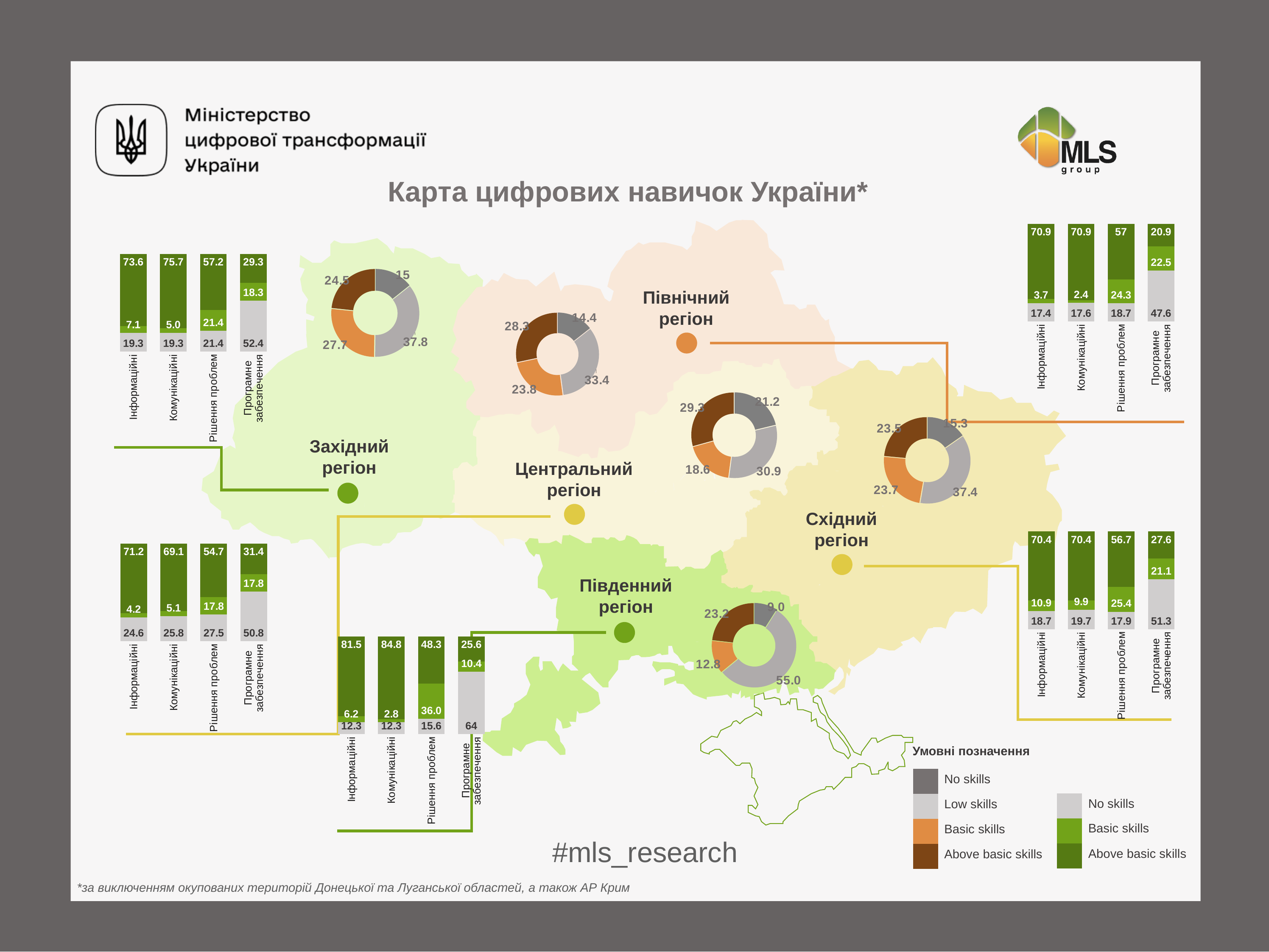
In the stacked bar chart at the bottom-middle of the slide, what is the No skills value for Програмне забезпечення? 64 In the donut chart for the Східний регіон (Eastern region), which slice is the smallest? No skills (15.3) How many categories does each stacked bar chart on the slide show? 4 In the stacked bar chart at the bottom-right of the slide, is the Above basic skills value for Інформаційні larger or smaller than the Above basic skills value for Рішення проблем? larger In the donut chart for the Центральний регіон (Central region), which slice is the largest? Low skills (30.9) How many skill levels does the legend list for the donut charts? 4 In the donut chart for the Південний регіон (Southern region), what is the value of the No skills slice? 9.0 In the stacked bar chart at the top-left of the slide, what is the Above basic skills value for Комунікаційні? 75.7 What type of chart is used to show the skill breakdown by category (Інформаційні, Комунікаційні, etc.) for each region? Stacked bar chart In the donut chart for the Північний регіон (Northern region), what is the difference between the Low skills slice and the No skills slice? 19.0 In the donut chart for the Західний регіон (Western region), what is the value of the Low skills slice? 37.8 In the stacked bar chart at the top-right of the slide, which category has the lowest Above basic skills value? Програмне забезпечення (20.9)